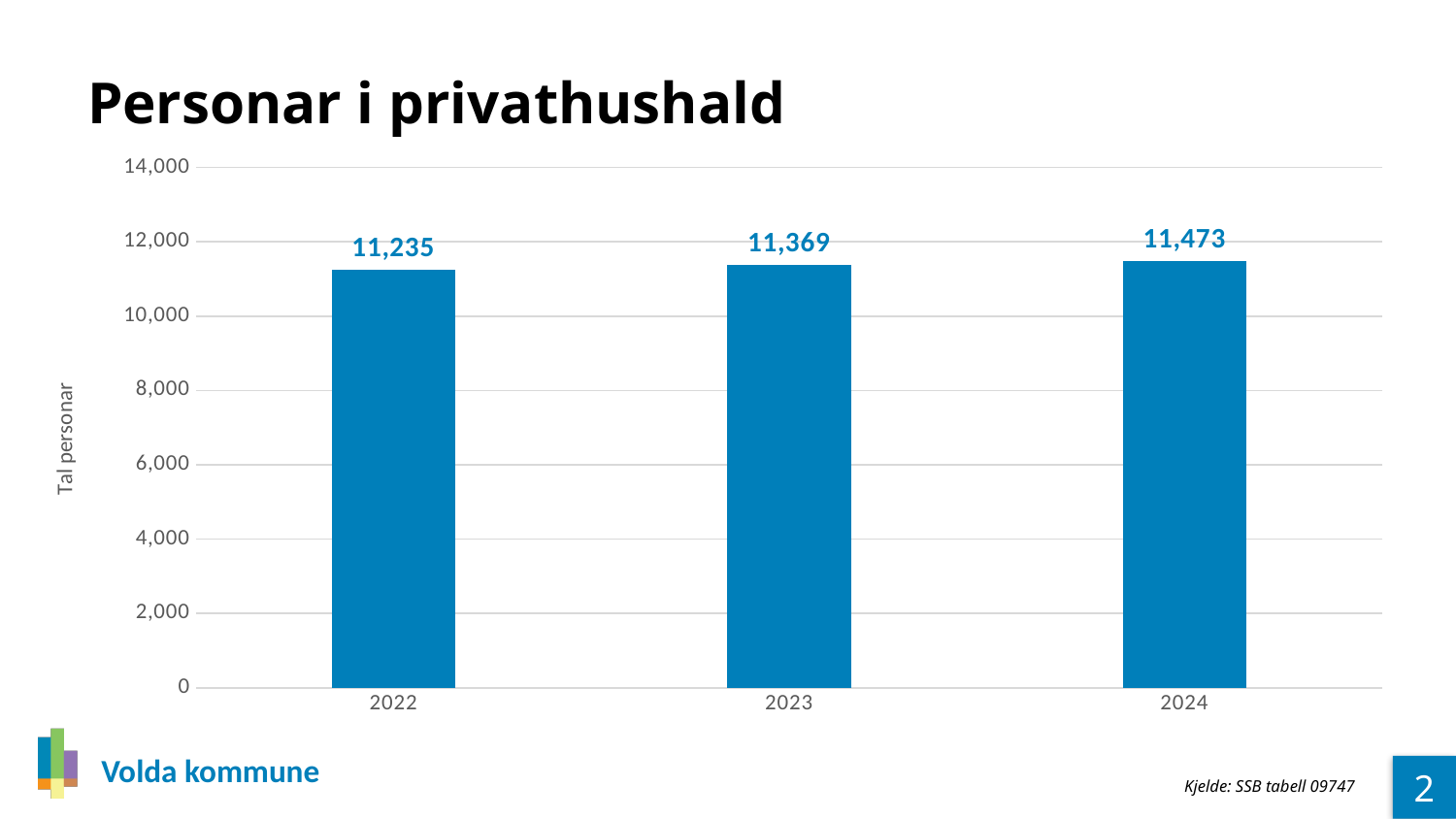
What is the value for 2023? 11,369 Do the values rise or fall from 2022 to 2024? rise What is the value for 2022? 11,235 Is the value for 2022 greater or less than 12,000? less What kind of chart is shown on the slide? bar chart What is the difference between the values for 2024 and 2022? 238 Which year has the lowest value? 2022 What is the value for 2024? 11,473 How many years are shown on the x axis? 3 What is the difference between the values for 2023 and 2022? 134 Which year has the highest value? 2024 Which is larger, the value for 2023 or the value for 2024? 2024